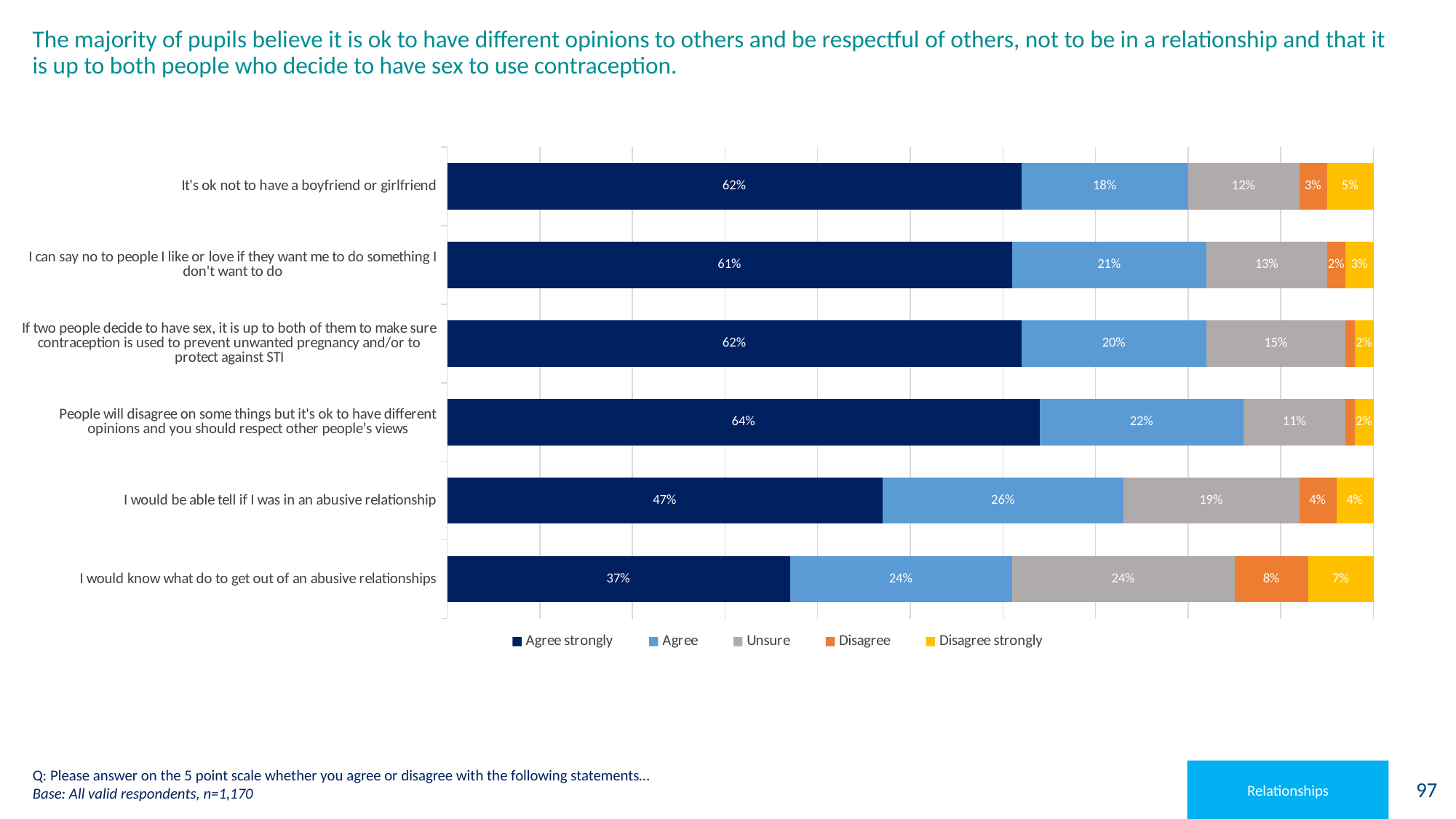
What is the Unsure value for the statement "I would be able tell if I was in an abusive relationship"? 19% Which statement has the highest Disagree percentage? I would know what do to get out of an abusive relationships What percentage of pupils agree strongly with the statement "I would know what do to get out of an abusive relationships"? 37% Which statement has the highest Agree strongly percentage? People will disagree on some things but it's ok to have different opinions and you should respect other people's views What percentage of pupils disagree strongly with the statement "It's ok not to have a boyfriend or girlfriend"? 5% What is the difference in the Agree strongly percentage between "It's ok not to have a boyfriend or girlfriend" and "I would be able tell if I was in an abusive relationship"? 15 percentage points How many response categories does the legend list? 5 What type of chart is shown on the slide? Stacked bar chart Which statement has the lowest Agree strongly percentage? I would know what do to get out of an abusive relationships What is the combined percentage of Agree strongly and Agree for the statement "I would know what do to get out of an abusive relationships"? 61% Which statement has a larger Unsure percentage: "I would know what do to get out of an abusive relationships" or "I would be able tell if I was in an abusive relationship"? I would know what do to get out of an abusive relationships How many statements are shown in the chart? 6